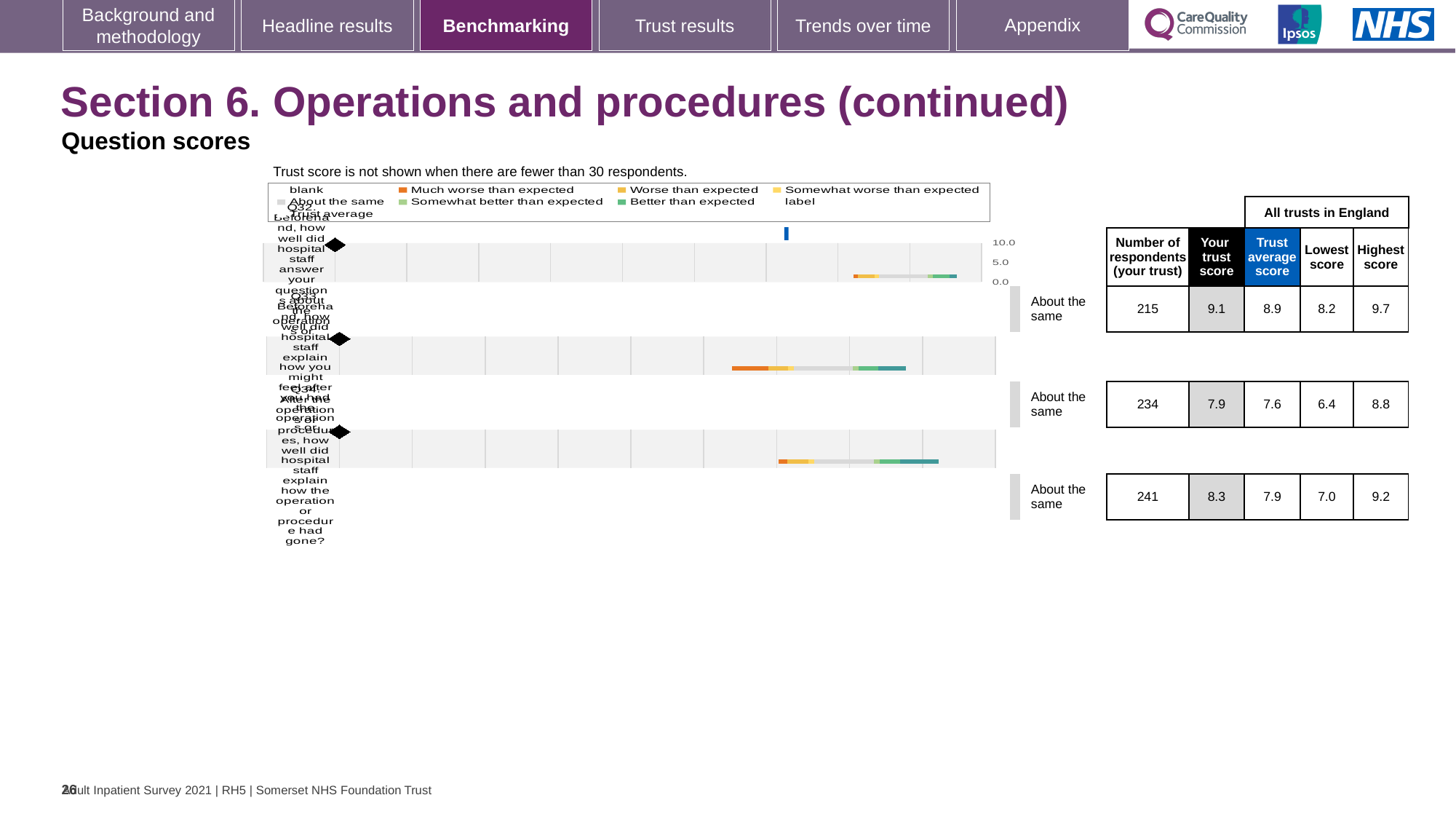
For the bottom question, what is the 'Highest score' across all trusts in England? 9.2 For the middle question, what is the 'Lowest score' across all trusts in England? 6.4 How many respondents does the top question have for your trust? 215 For the bottom question, what is the difference between 'Your trust score' and the 'Trust average score'? 0.4 How many questions (rows) are benchmarked on this slide? 3 What benchmark rating label is shown next to each of the three questions? About the same For the middle question, what is the 'Trust average score'? 7.6 For the middle question, which is larger: 'Your trust score' or the 'Trust average score'? Your trust score For the top question, what is the 'Your trust score' value? 9.1 What kind of chart is used to show the benchmarking results on this slide? bar chart Which of the three questions has the highest 'Your trust score'? the top question (9.1)